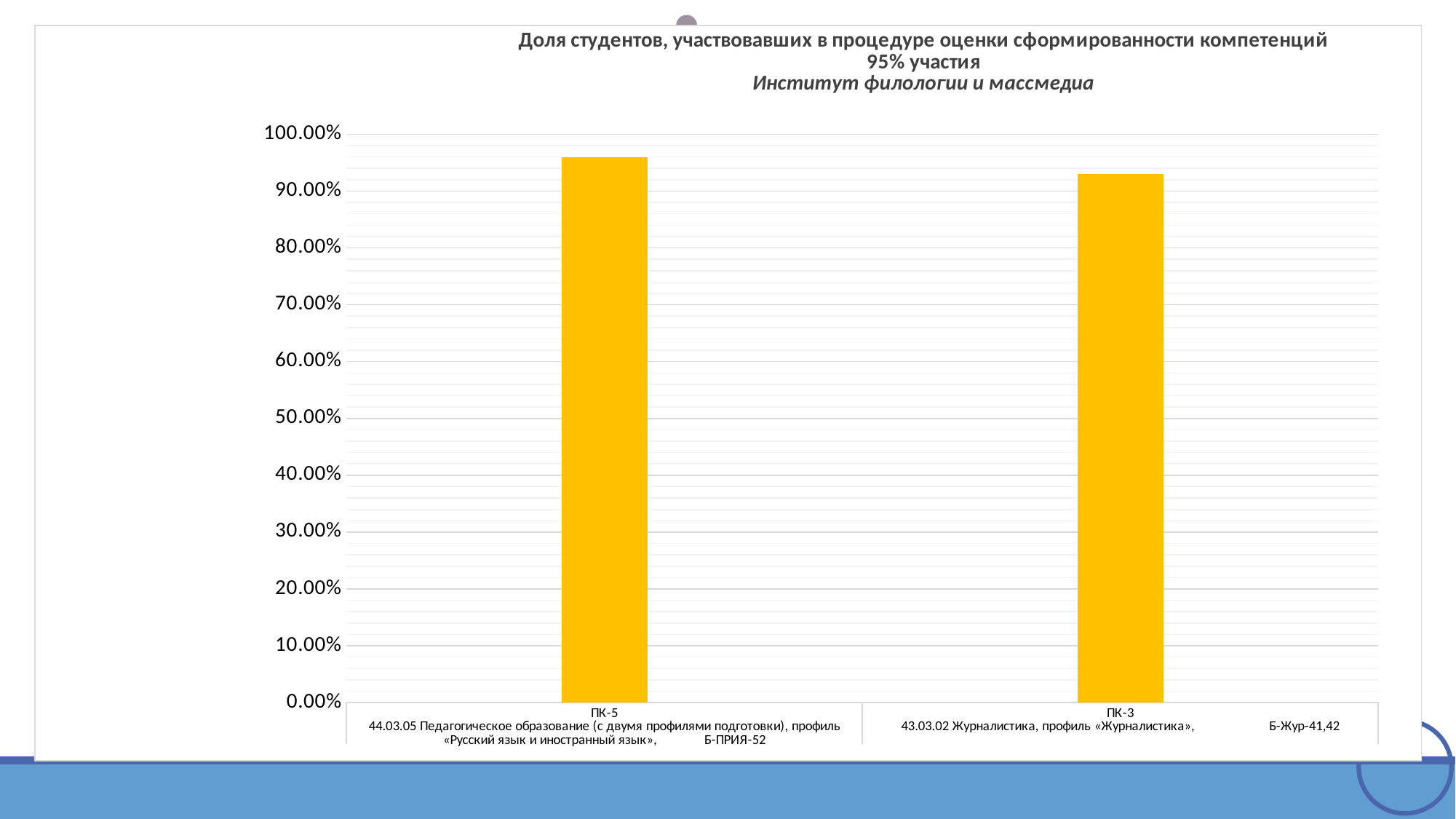
What is the highest tick value shown on the vertical axis? 100.00% How many bars (categories) are plotted in the chart? 2 Is the value for ПК-3 greater or less than 90.00%? greater Is the value for ПК-5 greater or less than 90.00%? greater Is the bar for ПК-5 taller or shorter than the bar for ПК-3? taller Which category has the lowest bar in the chart? ПК-3 Is the value for ПК-3 greater or less than 80.00%? greater What kind of chart is shown on the slide? bar chart Which category has the highest bar, ПК-5 or ПК-3? ПК-5 Which institute is named in the chart title? Институт филологии и массмедиа